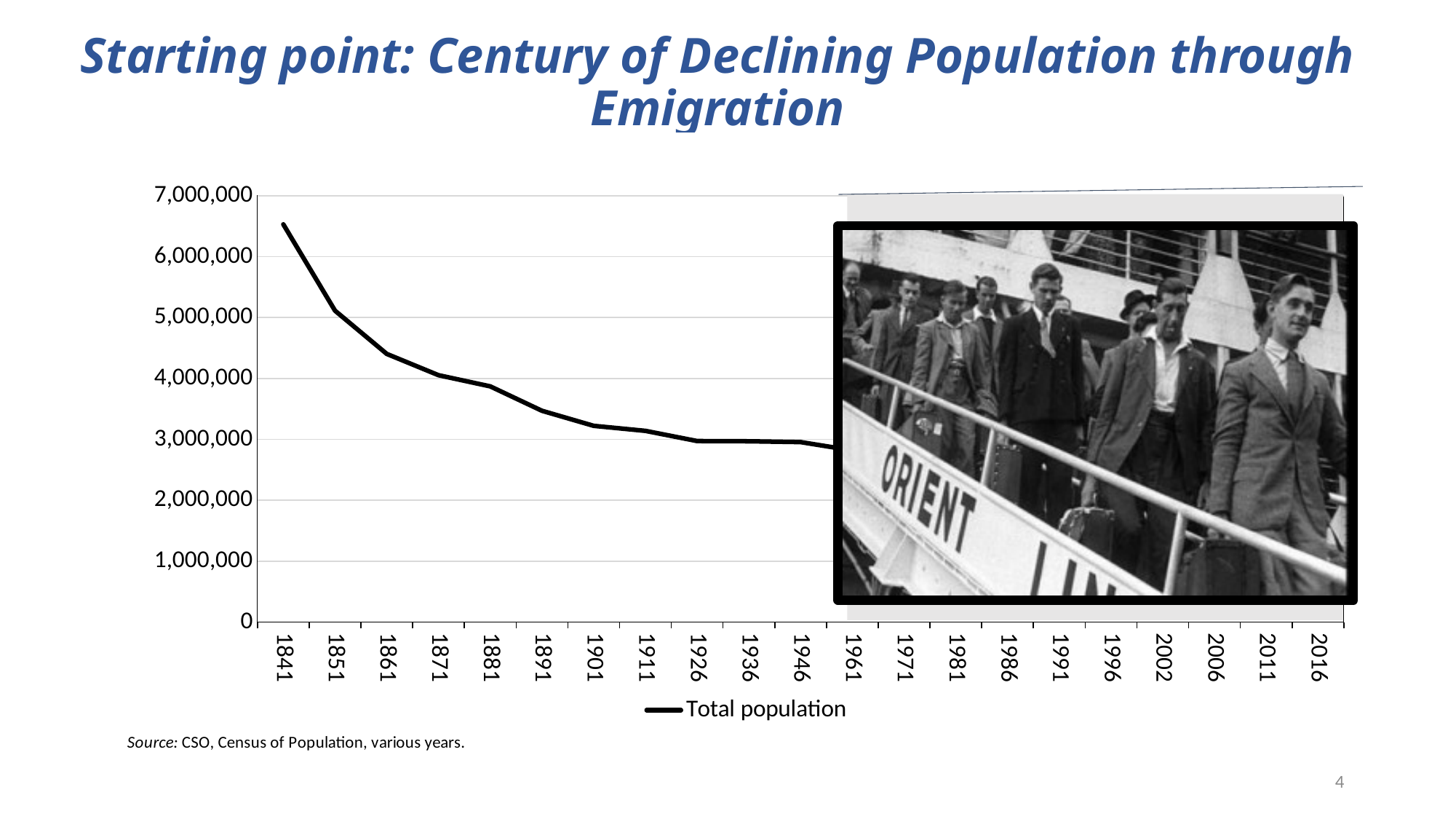
Which year shown on the chart has the highest total population? 1841 Is the total population for 1891 greater or less than 4,000,000? less Is the total population for 1861 greater or less than 4,000,000? greater What is the name of the series shown in the chart's legend? Total population Is the total population for 1841 greater or less than 6,000,000? greater Does the total population rise or fall along the x axis between 1841 and 1946? fall Which year has the higher total population, 1841 or 1901? 1841 What kind of chart is shown on the slide? line chart How many series does the chart's legend list? 1 How many years are labelled along the x axis of the chart? 21